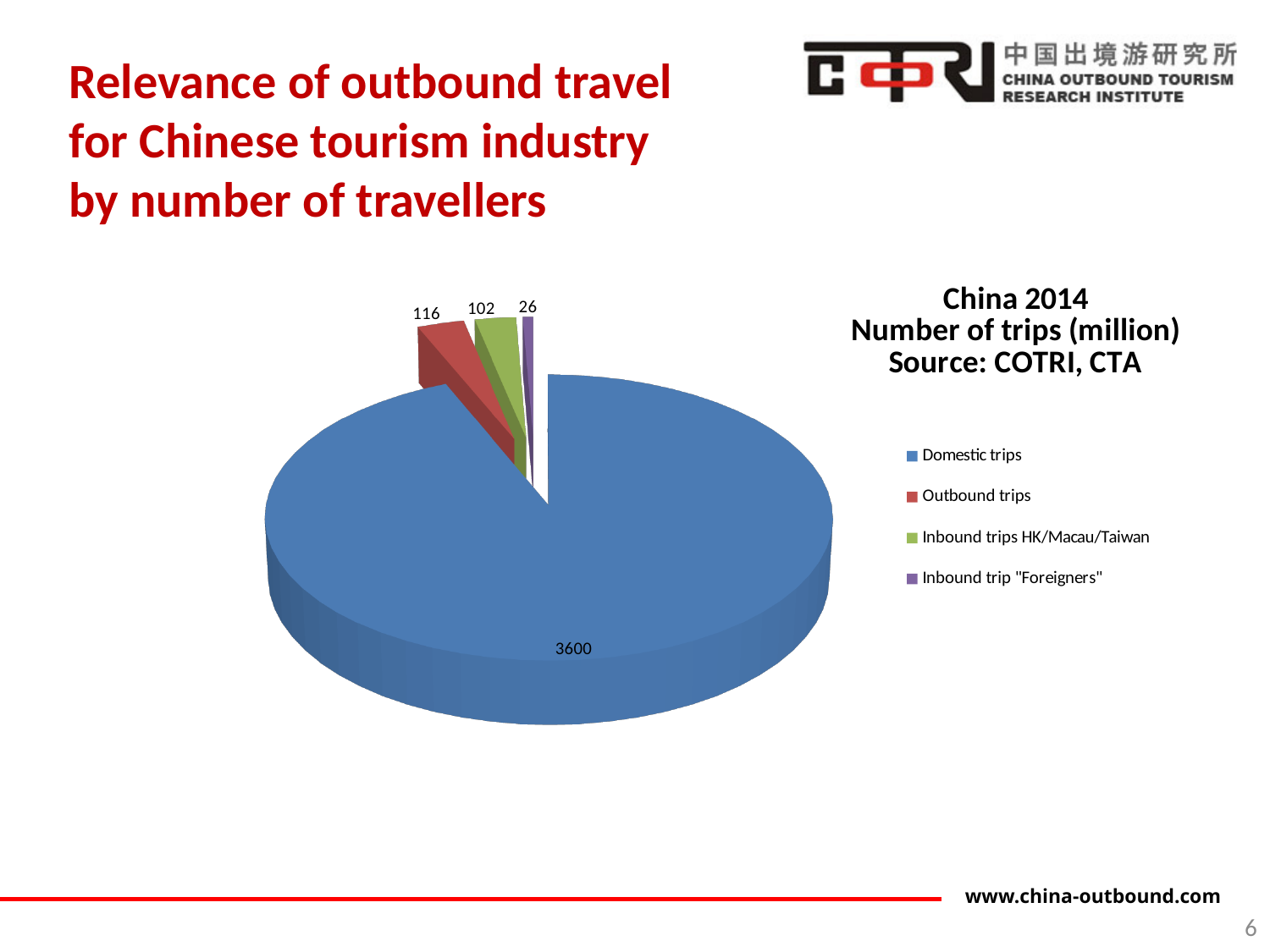
Which category has the largest slice of the pie? Domestic trips What is the value for Inbound trips HK/Macau/Taiwan? 102 What is the value for Domestic trips? 3600 Which category has the smallest slice of the pie? Inbound trip "Foreigners" What is the value for Outbound trips? 116 What type of chart is shown on the slide? Pie chart How many entries does the legend list? 4 What is the difference between the values for Outbound trips and Inbound trips HK/Macau/Taiwan? 14 What colour is the Domestic trips slice? Blue Which is larger, the value for Outbound trips or the value for Inbound trips HK/Macau/Taiwan? Outbound trips How many slices does the pie chart have? 4 What is the value for Inbound trip "Foreigners"? 26